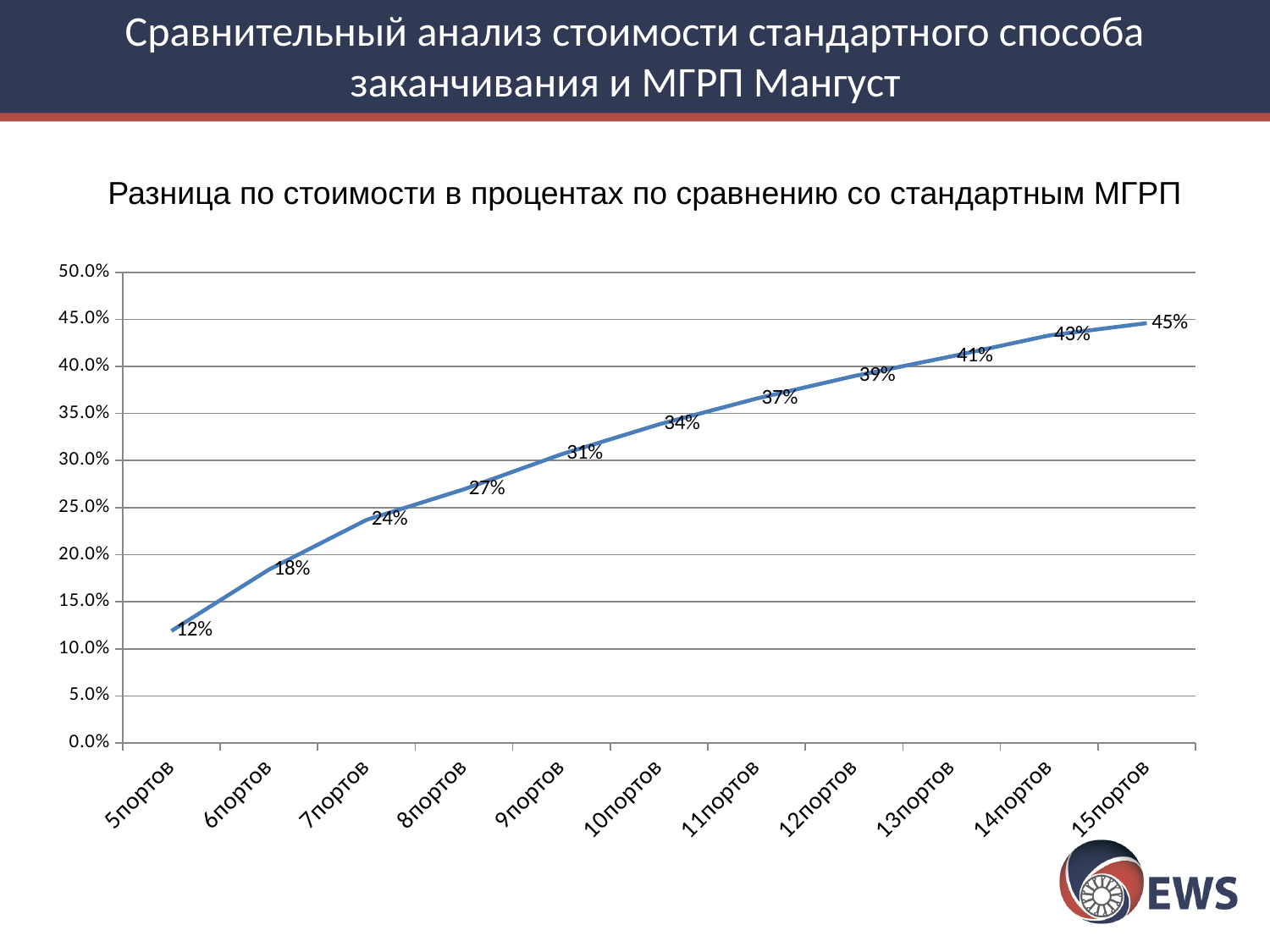
Which category has the lowest value? 5портов Which category has the highest value? 15портов What is the value for 5портов? 12% What is the difference between the values for 8портов and 7портов? 3% What is the value for 15портов? 45% Do the values rise or fall from 5портов to 15портов? rise What kind of chart is shown on the slide? line chart Which is larger, the value for 9портов or the value for 12портов? 12портов How many categories are plotted on the x axis? 11 What is the difference between the values for 15портов and 5портов? 33% What is the value for 10портов? 34% Is the value for 13портов greater or less than 40.0%? greater